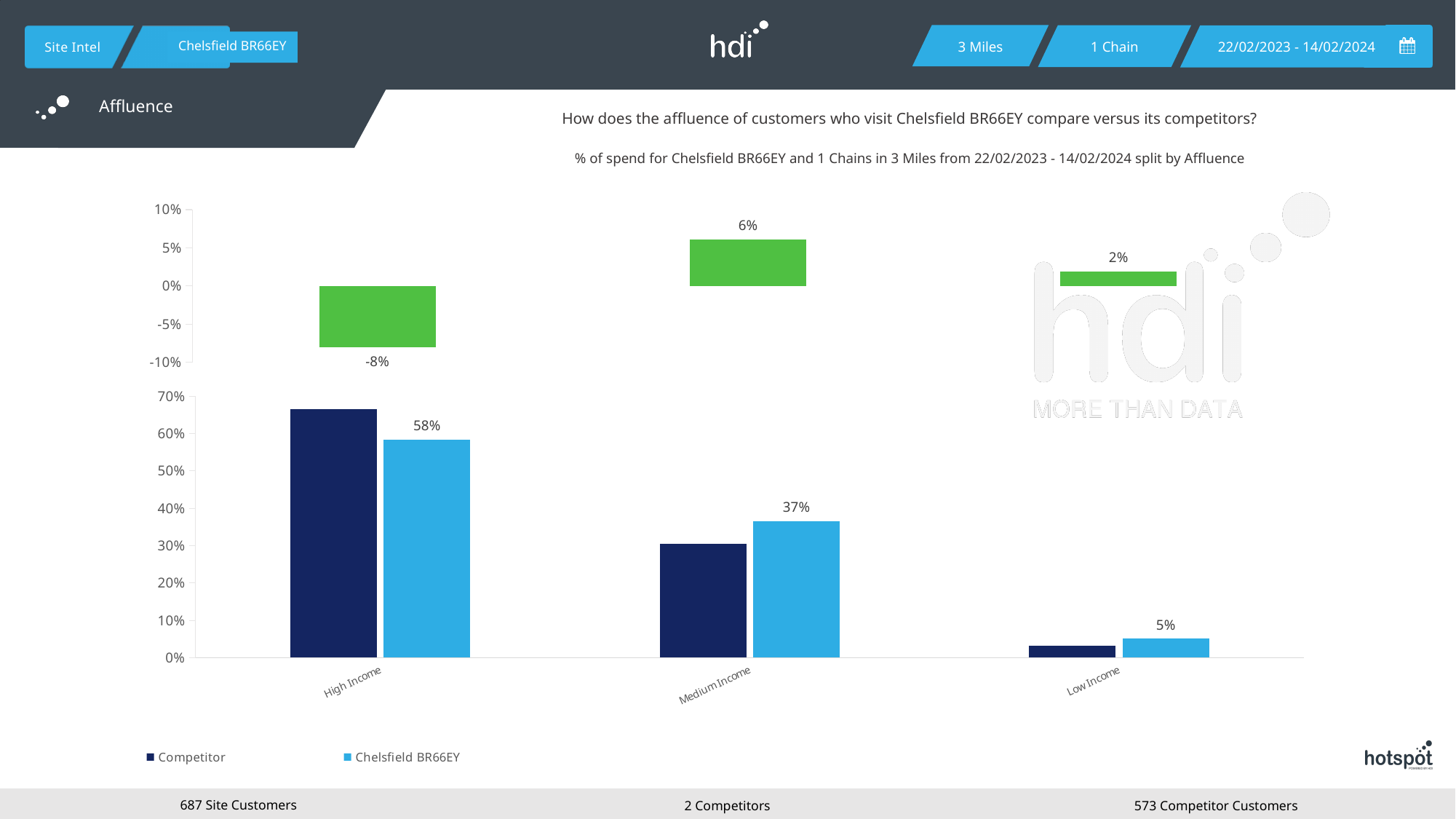
In the bottom chart, is the Competitor value for High Income greater or less than 60%? greater In the top chart, which category has the highest value? Medium Income In the top chart, what is the value for High Income? -8% In the top chart, what is the value for Low Income? 2% In the bottom chart, which is larger for Medium Income: Competitor or Chelsfield BR66EY? Chelsfield BR66EY In the bottom chart, what is the Chelsfield BR66EY value for Medium Income? 37% In the top chart, what is the value for Medium Income? 6% How many series does the legend of the bottom chart list? 2 In the top chart, which category has the lowest value? High Income In the bottom chart, what is the Chelsfield BR66EY value for High Income? 58% In the bottom chart, what is the Chelsfield BR66EY value for Low Income? 5% In the bottom chart, what is the difference between the Chelsfield BR66EY values for High Income and Medium Income? 21%